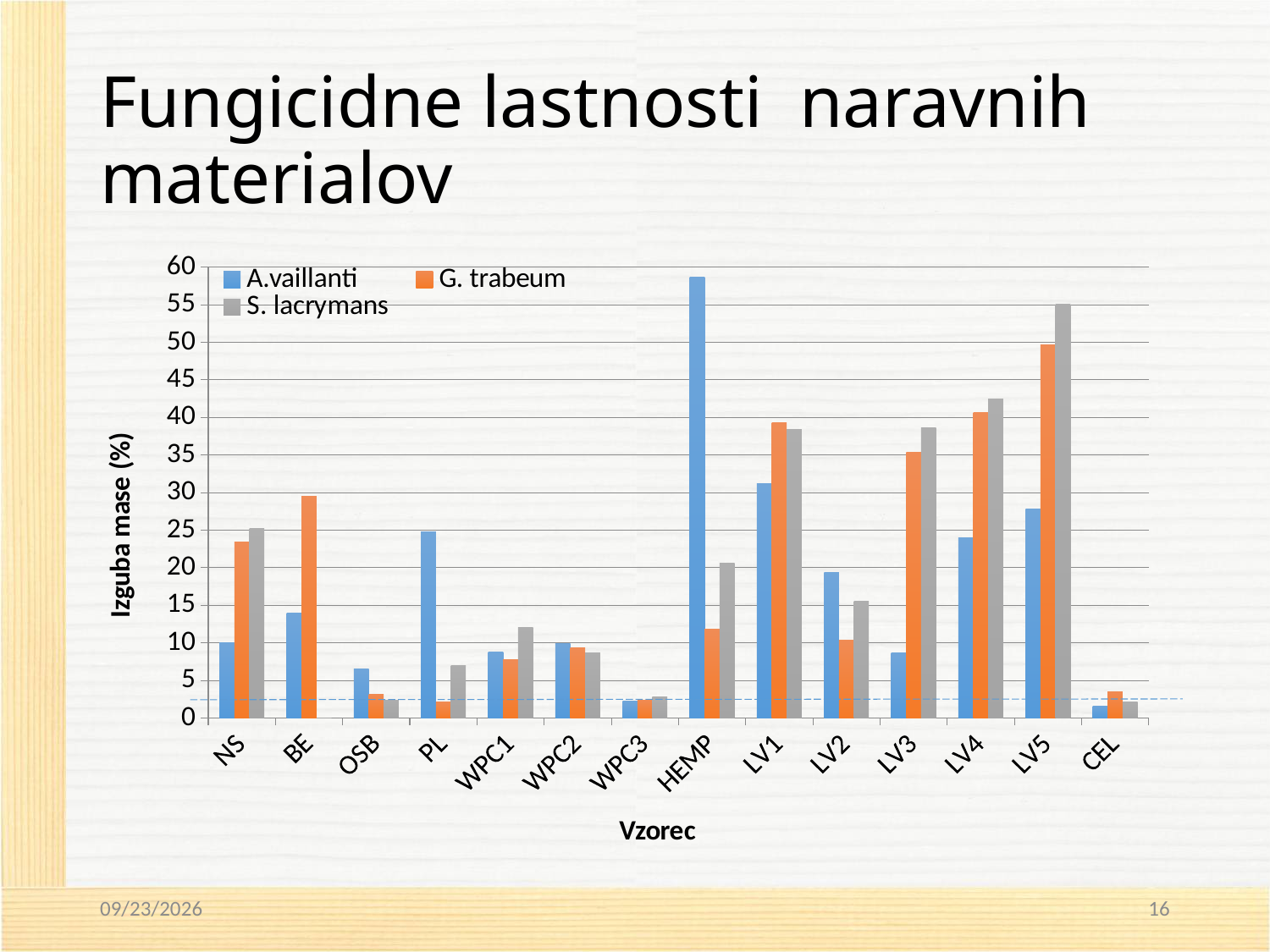
Is the G. trabeum value for OSB greater or less than 5? less Which category has the highest value for A.vaillanti? HEMP For LV5, which is larger: the G. trabeum value or the S. lacrymans value? S. lacrymans What is the title of the y axis? Izguba mase (%) How many categories are shown on the x axis? 14 What kind of chart is shown on the slide? bar chart Which category has the highest value for G. trabeum? LV5 For HEMP, which is larger: the A.vaillanti value or the G. trabeum value? A.vaillanti Which category has the highest value for S. lacrymans? LV5 How many series does the legend list? 3 Is the A.vaillanti value for HEMP greater or less than 50? greater Is the G. trabeum value for BE greater or less than 25? greater